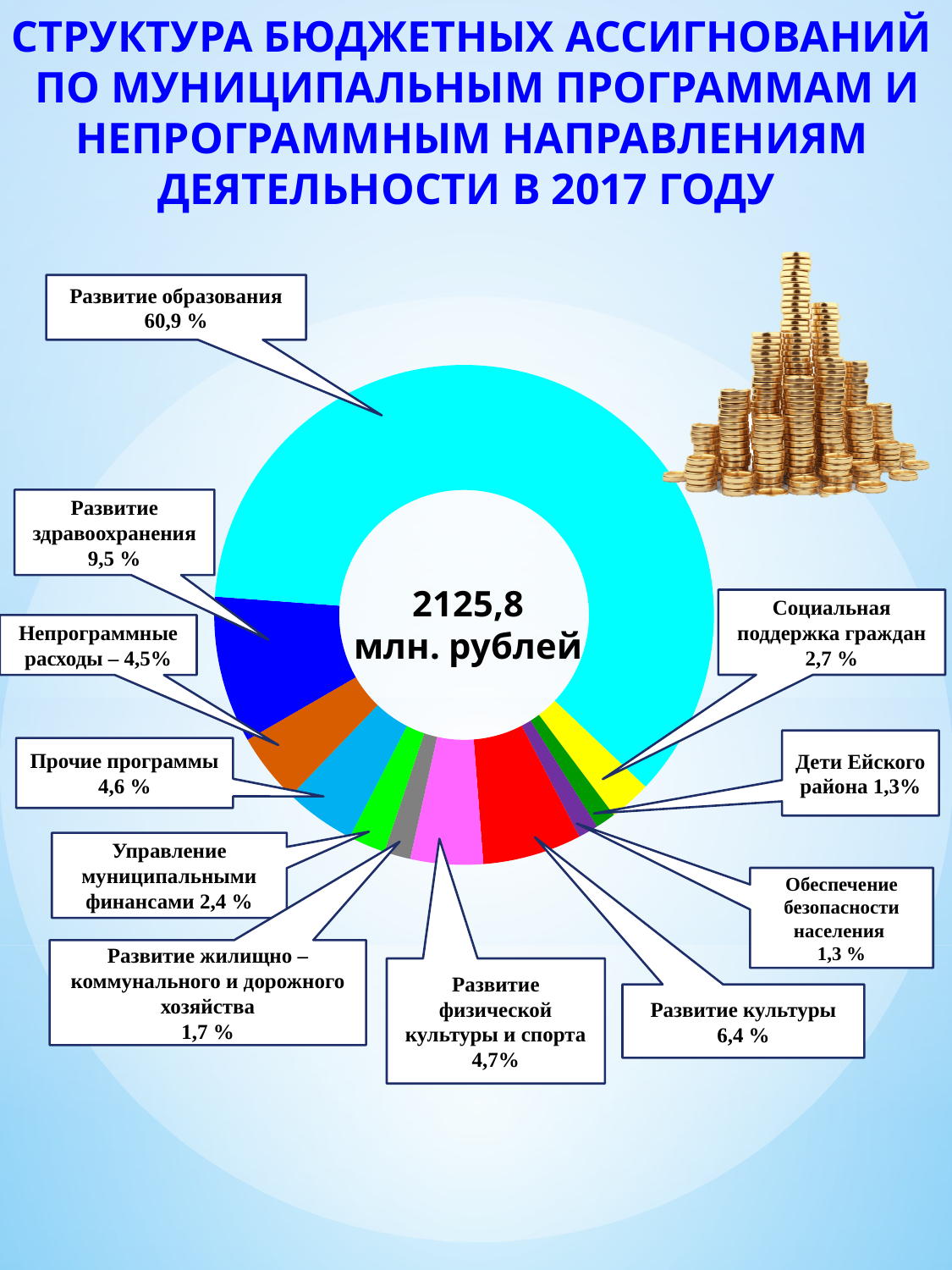
How many categories are shown in the chart? 11 What total amount is shown in the centre of the chart? 2125,8 млн. рублей Which is larger: the share for Прочие программы or for Непрограммные расходы? Прочие программы What kind of chart is shown on the slide? doughnut chart What share of the budget goes to Развитие здравоохранения? 9,5 % What share of the budget goes to Развитие культуры? 6,4 % What share of the budget goes to Управление муниципальными финансами? 2,4 % What is the difference in percentage points between Развитие здравоохранения and Развитие культуры? 3,1 What share of the budget goes to Развитие физической культуры и спорта? 4,7% What share of the budget goes to Развитие образования? 60,9 % Which category has the largest share of the budget? Развитие образования What share of the budget goes to Социальная поддержка граждан? 2,7 %